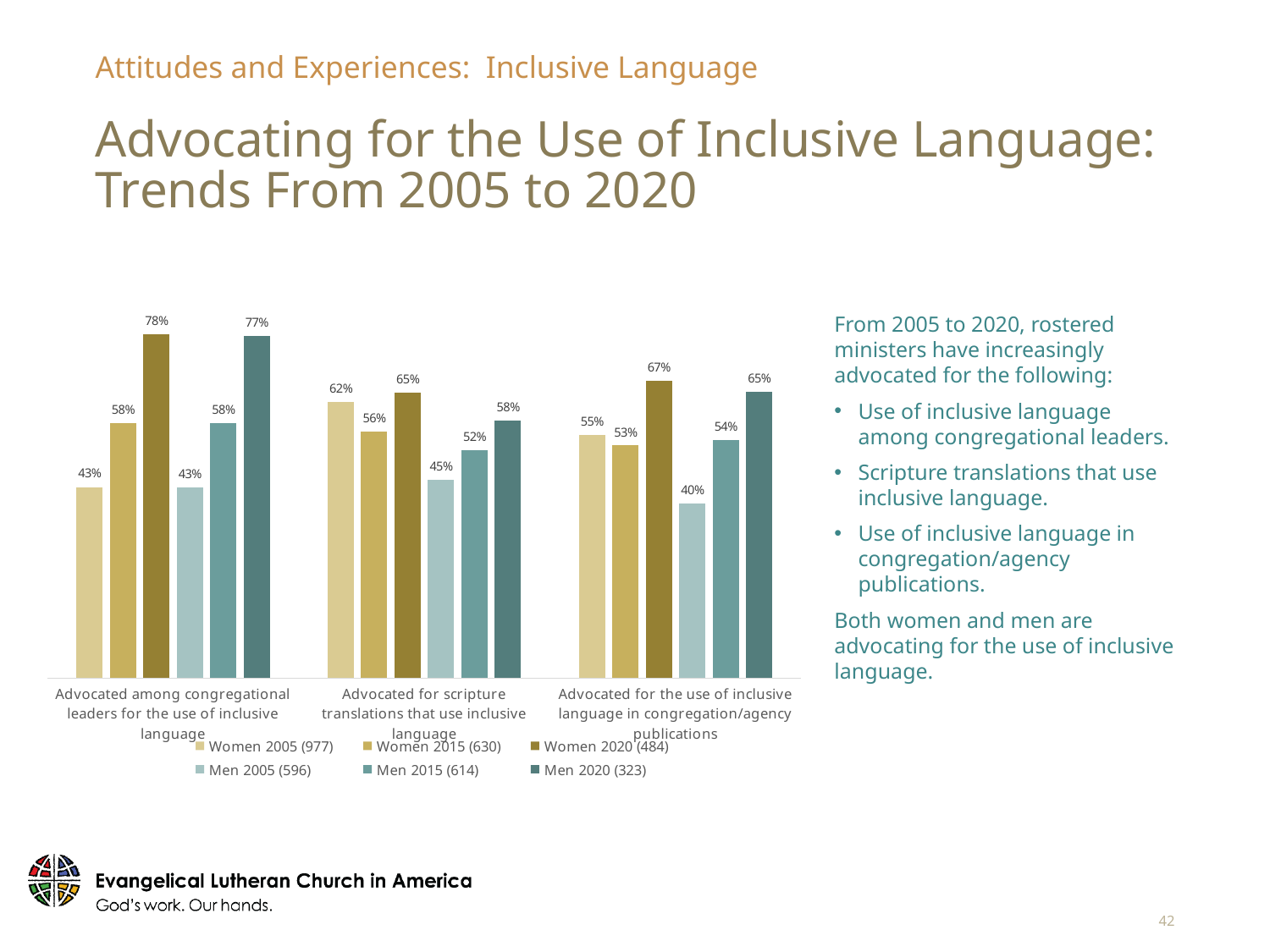
How many categories are shown on the x axis? 3 Which series has the highest value in the 'Advocated among congregational leaders for the use of inclusive language' category? Women 2020 What is the value for Men 2005 in the 'Advocated for the use of inclusive language in congregation/agency publications' category? 40% What is the value for Women 2020 in the 'Advocated among congregational leaders for the use of inclusive language' category? 78% How many series does the legend list? 6 Which series has the lowest value in the 'Advocated for scripture translations that use inclusive language' category? Men 2005 What is the difference between the Women 2020 and Women 2005 values in the 'Advocated for the use of inclusive language in congregation/agency publications' category? 12% What sample size is shown in the legend for Women 2005? 977 What kind of chart is shown on the slide? Bar chart What is the value for Women 2005 in the 'Advocated for scripture translations that use inclusive language' category? 62% Do the Men values rise or fall from 2005 to 2020 in the 'Advocated for the use of inclusive language in congregation/agency publications' category? Rise In the 'Advocated for scripture translations that use inclusive language' category, which is larger: Women 2015 or Men 2015? Women 2015